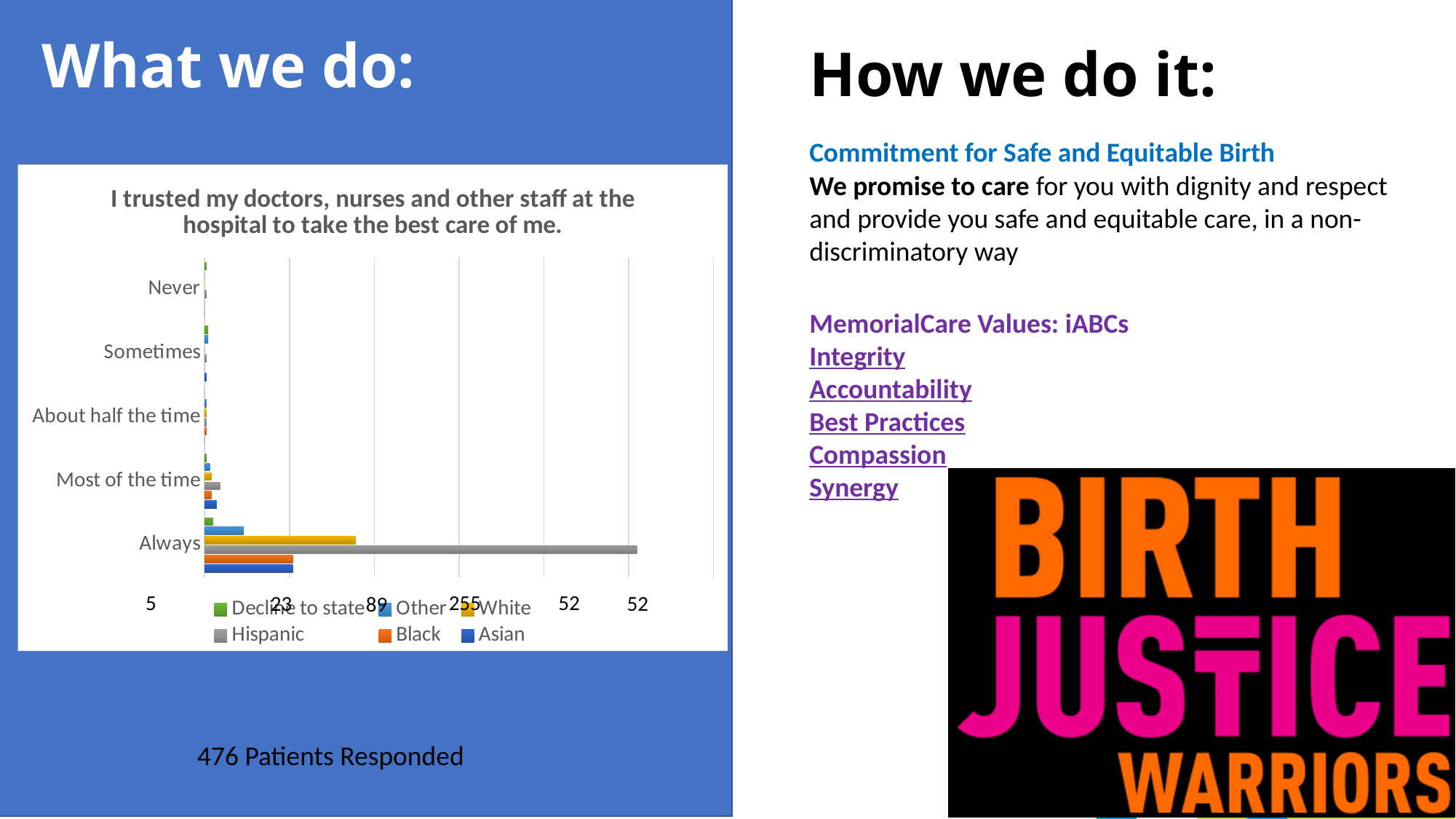
In the Always category, which is larger, the White bar or the Other bar? White What is the title of the chart? I trusted my doctors, nurses and other staff at the hospital to take the best care of me. Which response category has the shortest bars in the chart? Never Which response category has the longest bars in the chart? Always How many response categories are shown on the y axis of the chart? 5 In the Always category, which is larger, the Hispanic bar or the White bar? Hispanic What kind of chart is shown on the slide? bar chart In the Always category, which is larger, the Black bar or the Other bar? Black How many series does the chart's legend list? 6 Which series has the longest bar in the Always category? Hispanic What colour represents the Hispanic series in the chart? gray